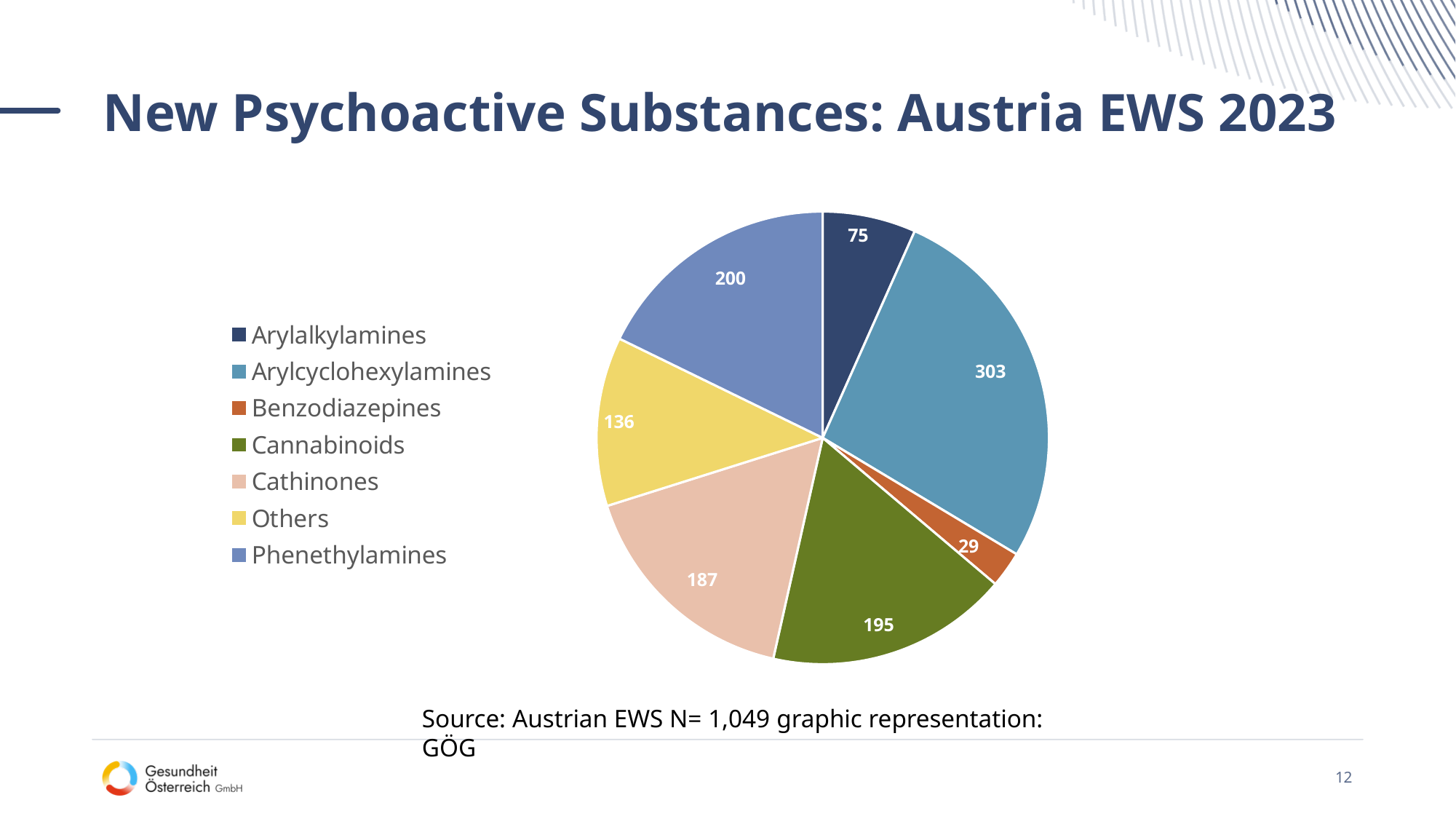
What value is shown for Phenethylamines in the pie chart? 200 What is the title of the slide containing the chart? New Psychoactive Substances: Austria EWS 2023 Which category has the smallest slice in the pie chart? Benzodiazepines What type of chart is shown on the slide? Pie chart What value is shown for Benzodiazepines in the pie chart? 29 What value is shown for Others in the pie chart? 136 What is the difference between the values for Arylcyclohexylamines and Phenethylamines? 103 Which category has the largest slice in the pie chart? Arylcyclohexylamines How many categories does the pie chart show? 7 Which is larger, the value for Cannabinoids or the value for Phenethylamines? Phenethylamines What value is shown for Arylcyclohexylamines in the pie chart? 303 What is the difference between the values for Cannabinoids and Cathinones? 8